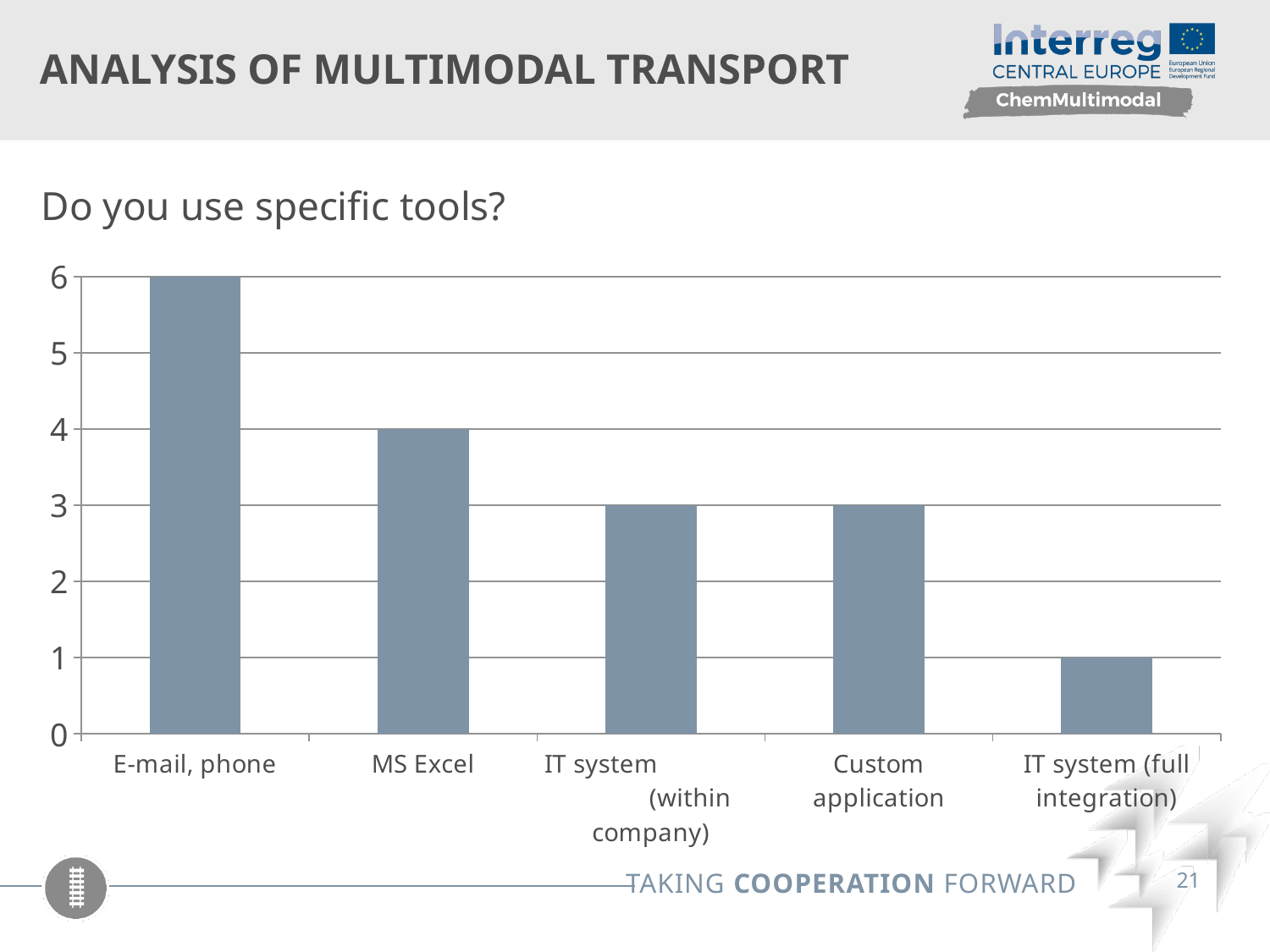
What kind of chart is shown on the slide? Bar chart What is the value for E-mail, phone? 6 What question is the chart answering, as shown above it? Do you use specific tools? What is the value for IT system (full integration)? 1 Which category has the lowest value? IT system (full integration) What is the difference between the values for E-mail, phone and MS Excel? 2 Which is larger, the value for MS Excel or the value for Custom application? MS Excel How many categories are shown on the x axis? 5 What is the value for Custom application? 3 What is the value for MS Excel? 4 Which category has the highest value? E-mail, phone What is the difference between the values for MS Excel and IT system (full integration)? 3